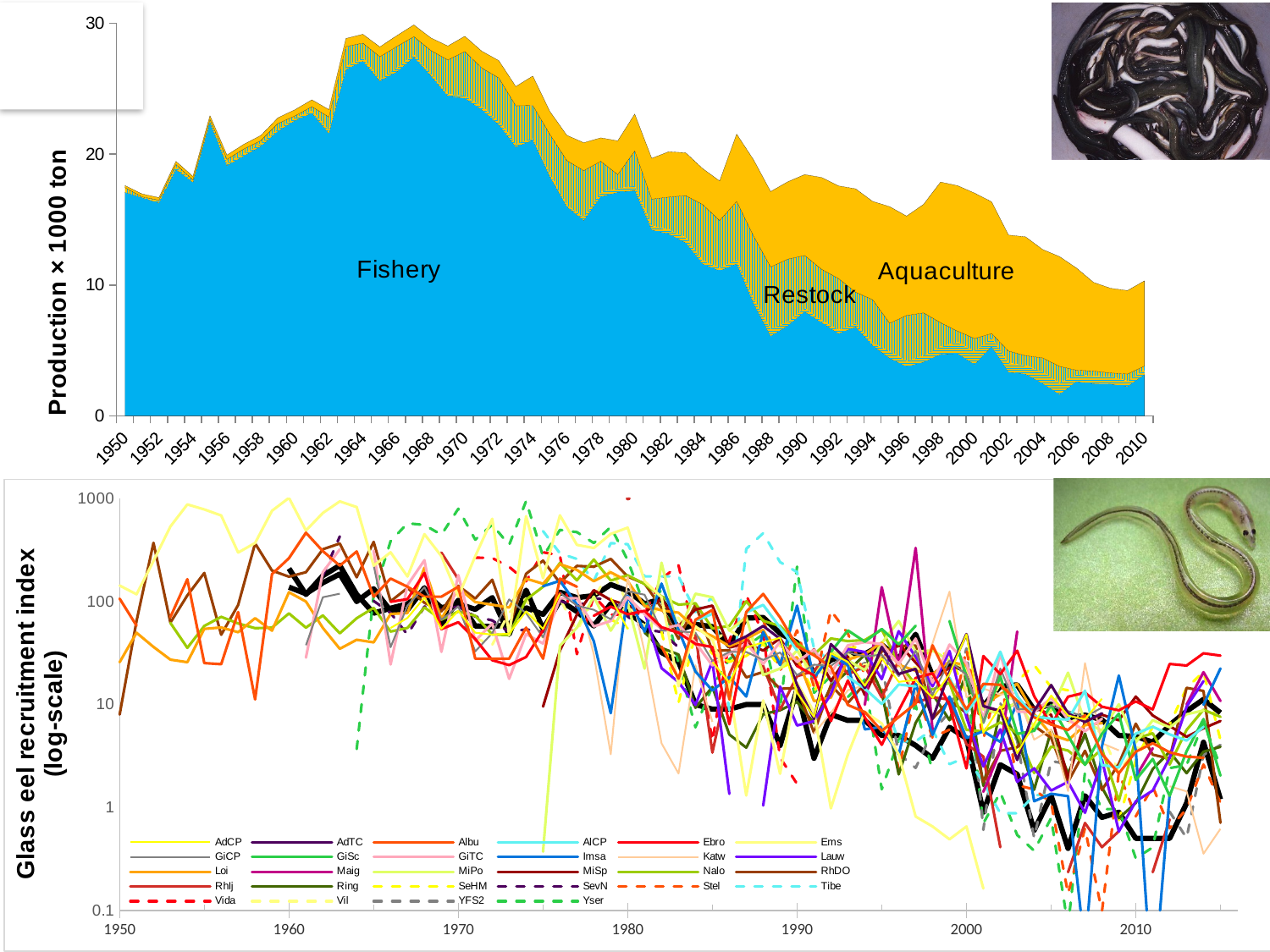
In the bottom chart, does the glass eel recruitment index generally rise or fall from 1980 to 2010? Fall In the top chart, does total production rise or fall between 1968 and 2010? Fall In the top chart, what are the three labelled production categories? Fishery, Restock, Aquaculture In the bottom chart, how many series does the legend list? 28 In the bottom chart, what is the highest value shown on the y-axis? 1000 In the top chart, how many production categories are labelled in the plot area? 3 In the top chart, is the total production in 1950 greater or less than 20? less In the top chart, is the Fishery production in 2010 greater or less than 10? less What kind of chart is the bottom chart showing the glass eel recruitment index? Line chart In the top chart, is the total production in 1968 greater or less than 20? greater What kind of chart is the top chart showing production? Stacked area chart In the top chart, what is the y-axis label? Production × 1000 ton